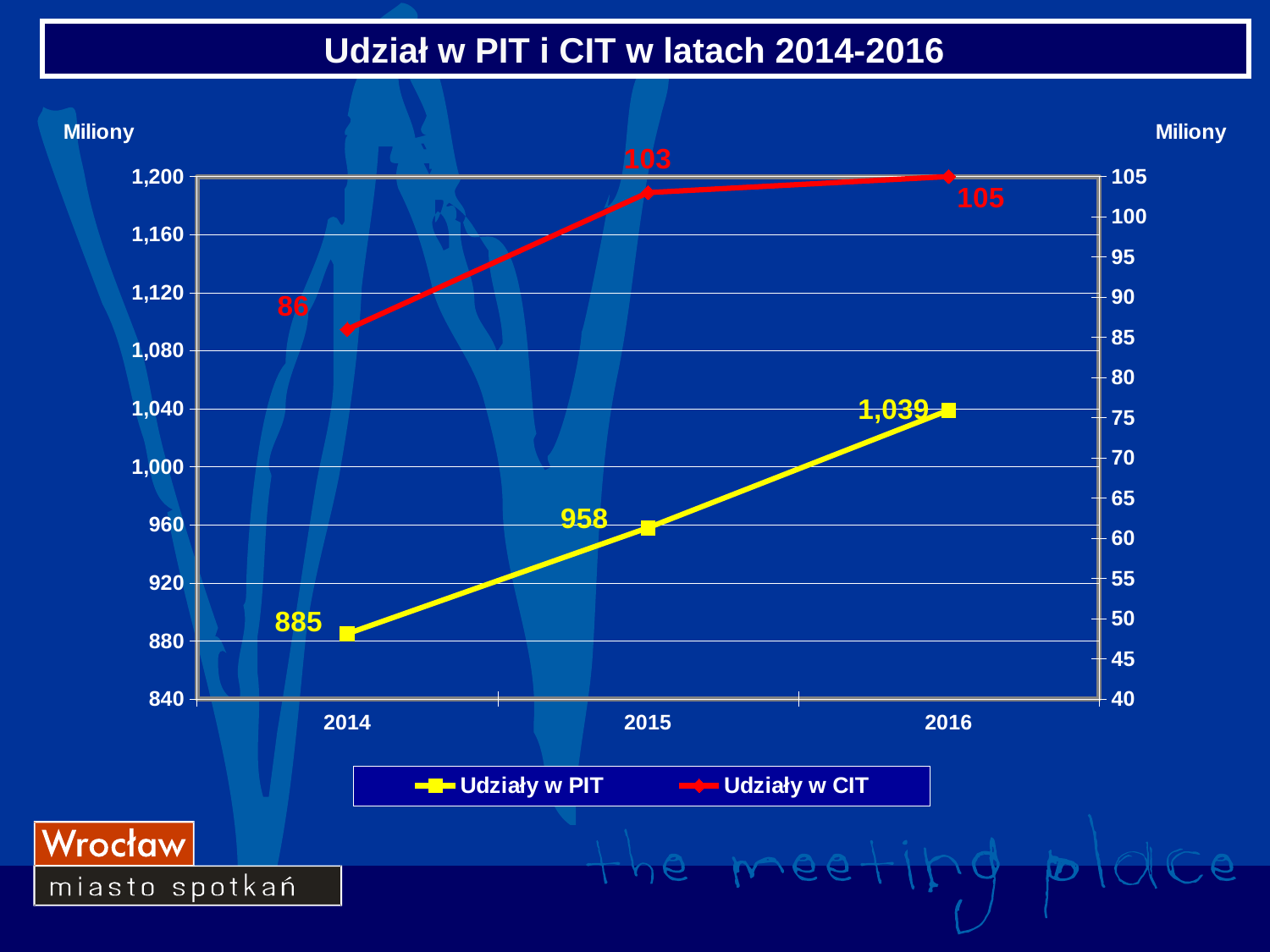
What kind of chart is shown on the slide? line chart What is the value for Udziały w CIT in 2014? 86 In which year is Udziały w CIT lowest? 2014 How many series does the legend list? 2 What is the value for Udziały w PIT in 2016? 1,039 In which year is Udziały w PIT highest? 2016 Which is larger for Udziały w PIT: the value in 2015 or in 2014? 2015 What is the difference between Udziały w CIT in 2015 and in 2014? 17 What is the value for Udziały w CIT in 2015? 103 What is the difference between Udziały w PIT in 2016 and in 2014? 154 How many years are shown on the x axis? 3 What is the value for Udziały w PIT in 2014? 885